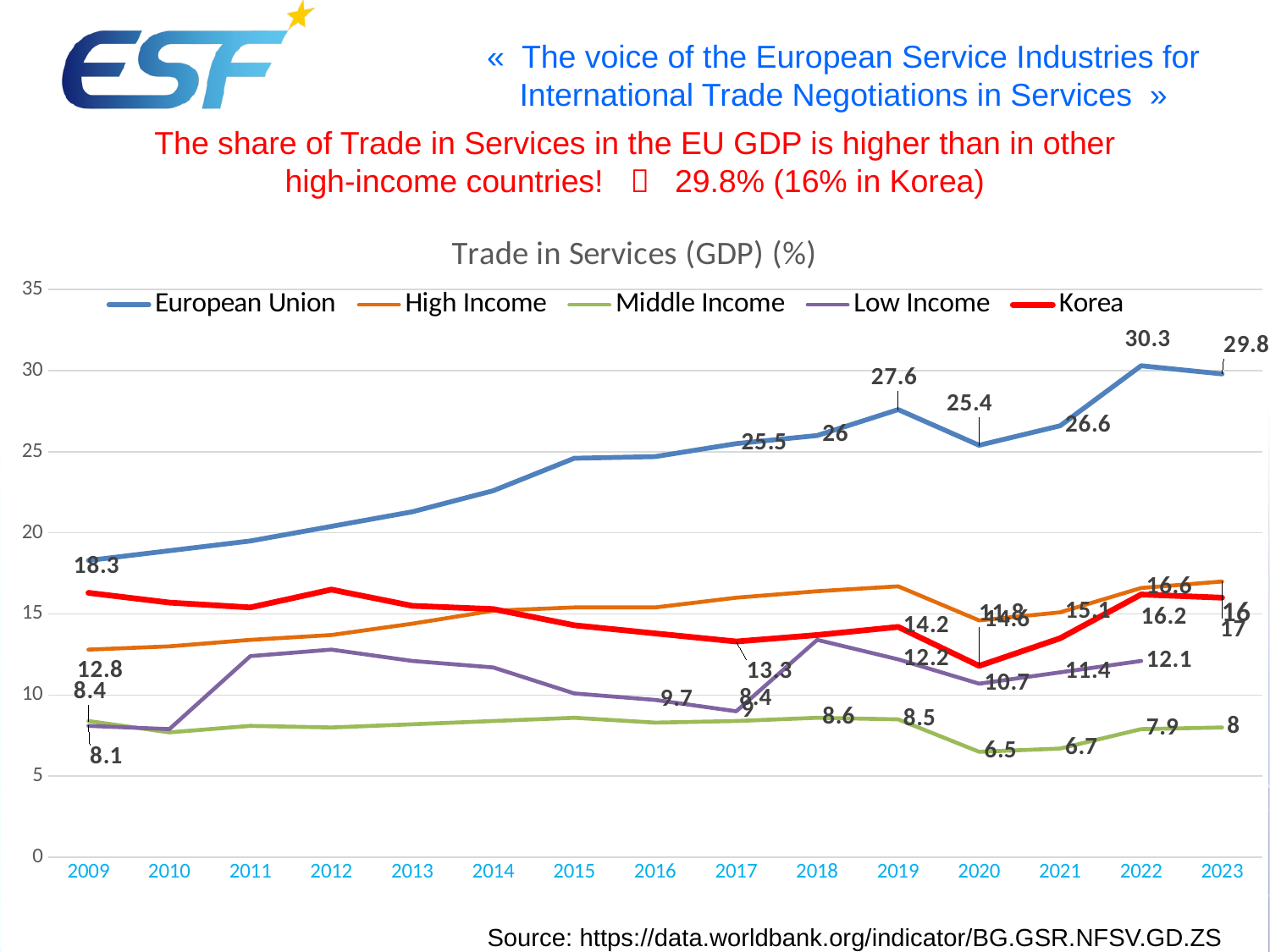
How many years are shown on the x axis? 15 In which year does the European Union reach its highest value? 2022 What is the value for Middle Income in 2020? 6.5 Is the value for the European Union in 2015 greater or less than 20? greater What is the value for the European Union in 2023? 29.8 What is the difference between the European Union value in 2022 and in 2023? 0.5 Which is larger in 2023, the European Union value or the Korea value? European Union What is the value for Korea in 2023? 16 How many series does the legend list? 5 What kind of chart is shown on the slide? Line chart What is the value for the European Union in 2009? 18.3 In which year is the Middle Income value lowest? 2020